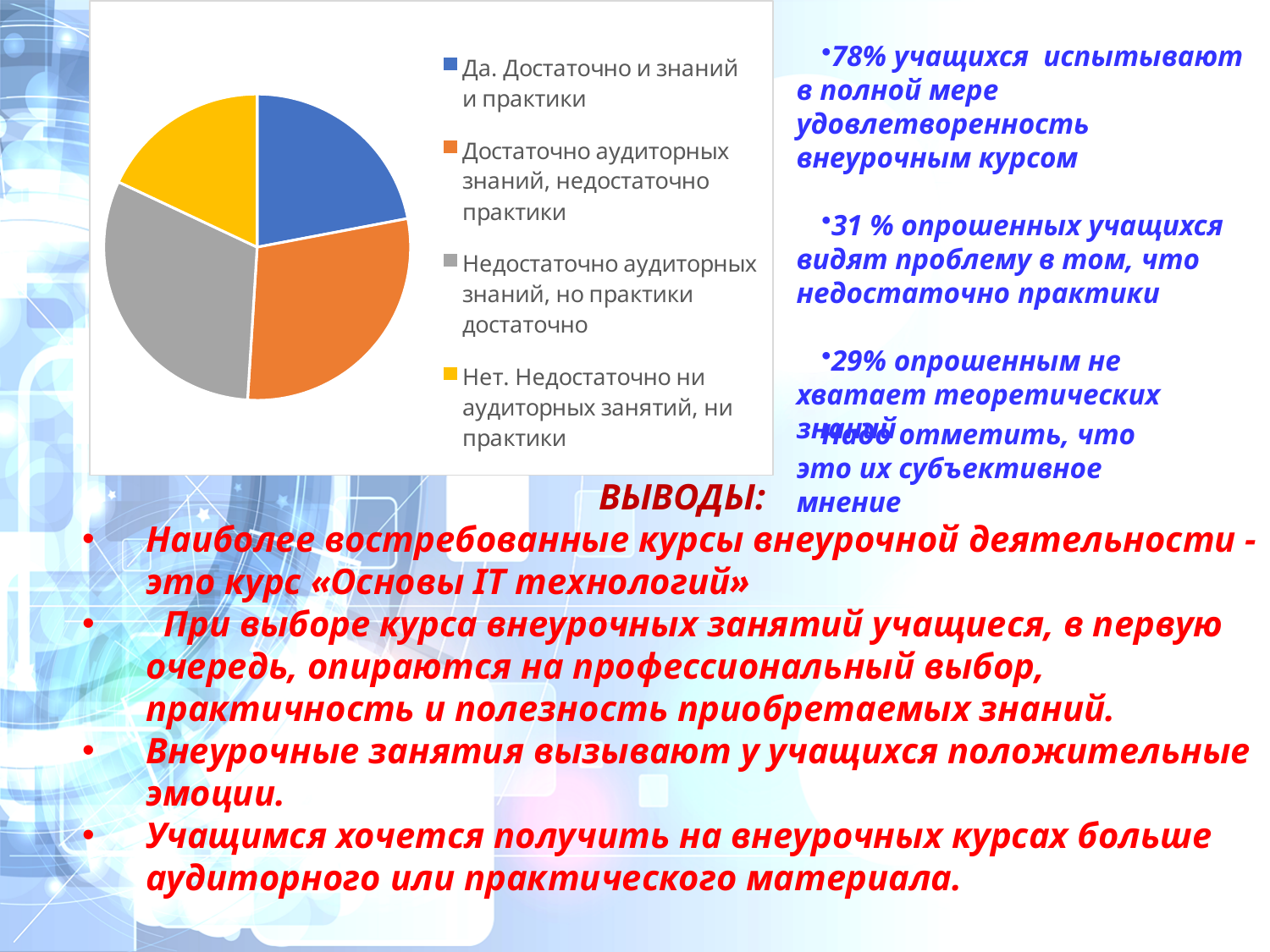
Which slice is larger: "Да. Достаточно и знаний и практики" or "Нет. Недостаточно ни аудиторных занятий, ни практики"? Да. Достаточно и знаний и практики Which slice is larger: "Достаточно аудиторных знаний, недостаточно практики" or "Нет. Недостаточно ни аудиторных занятий, ни практики"? Достаточно аудиторных знаний, недостаточно практики How many slices does the pie chart have? 4 Which slice is larger: "Недостаточно аудиторных знаний, но практики достаточно" or "Да. Достаточно и знаний и практики"? Недостаточно аудиторных знаний, но практики достаточно What colour is the slice for "Достаточно аудиторных знаний, недостаточно практики" in the pie chart? Orange How many entries does the legend of the pie chart list? 4 What kind of chart is shown on the slide? Pie chart Which category has the smallest slice in the pie chart? Нет. Недостаточно ни аудиторных занятий, ни практики Which category is shown in yellow in the pie chart? Нет. Недостаточно ни аудиторных занятий, ни практики